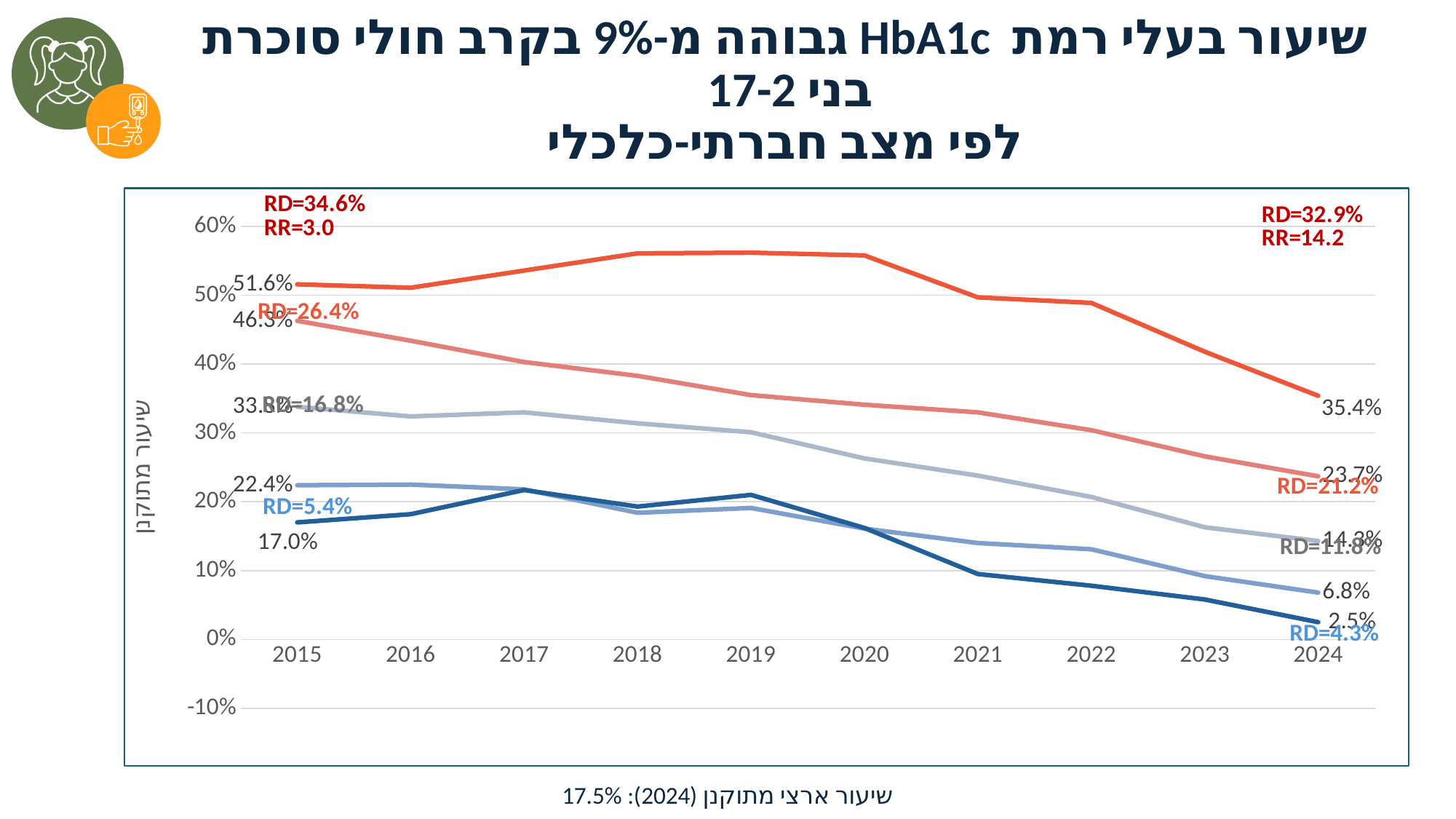
What kind of chart is shown on the slide? line chart What is the difference in 2024 between the light red line (23.7%) and the grey-blue line (14.3%)? 9.4 percentage points By how many percentage points did the topmost (dark orange) line fall from 2015 to 2024? 16.2 percentage points How many years are shown along the x axis of the chart? 10 How many lines are plotted on the chart? 5 Is the value of the topmost (dark orange) line in 2018 greater or less than 50%? greater What is the value of the lowest (dark blue) line in 2024? 2.5% What is the value of the topmost (dark orange) line in 2015? 51.6% What national adjusted rate for 2024 is given in the note below the chart? 17.5% What is the value of the lowest (dark blue) line in 2015? 17.0% What is the value of the topmost (dark orange) line in 2024? 35.4% Does the topmost (dark orange) line rise or fall overall from 2015 to 2024? fall